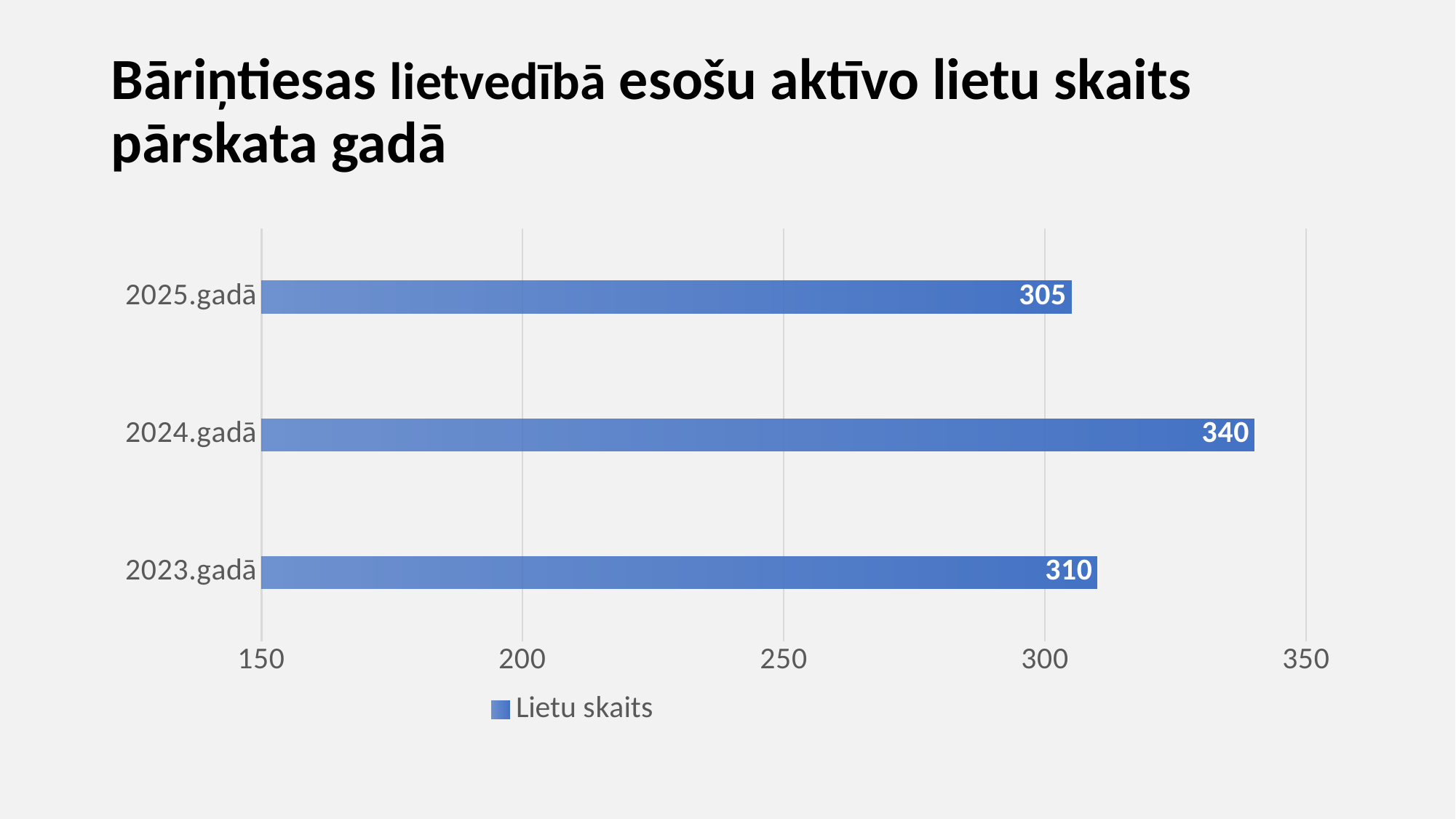
What is the difference between the values for 2024.gadā and 2025.gadā? 35 What series name does the legend show? Lietu skaits How many categories are shown in the chart? 3 Which year has the lowest value? 2025.gadā What is the value for 2024.gadā? 340 Which year has the highest value? 2024.gadā What is the difference between the values for 2023.gadā and 2025.gadā? 5 Is the value for 2024.gadā greater or less than 300? greater What kind of chart is shown on the slide? bar chart What is the value for 2025.gadā? 305 Which is larger, the value for 2023.gadā or the value for 2024.gadā? 2024.gadā What is the value for 2023.gadā? 310